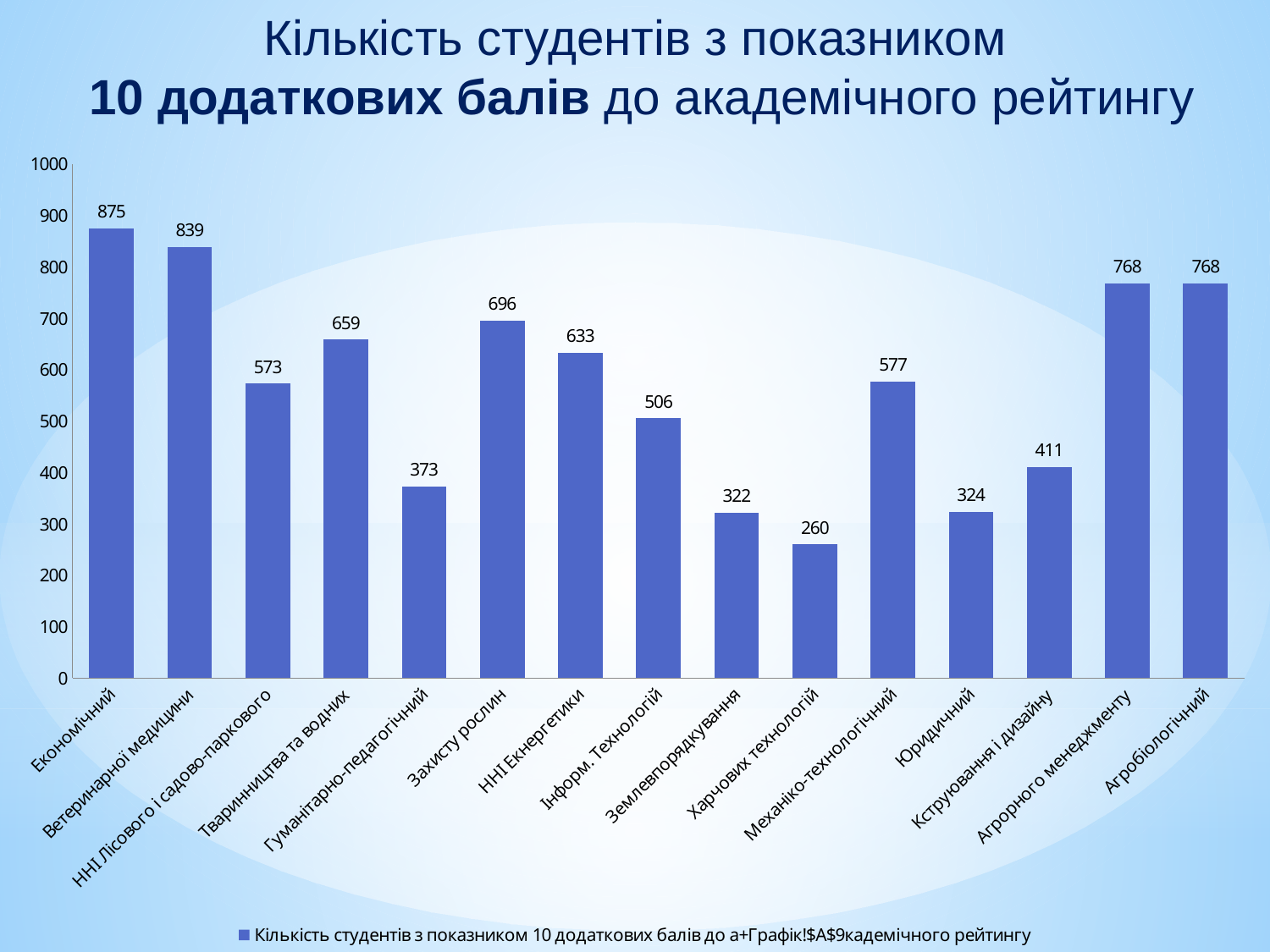
What kind of chart is shown on the slide? bar chart How many series does the legend list? 1 How many categories are shown on the x axis? 15 Which category has the highest value? Економічний What is the difference between the values for Економічний and Ветеринарної медицини? 36 What is the value for Економічний? 875 What is the value for Харчових технологій? 260 Which category has the lowest value? Харчових технологій What is the difference between the values for Юридичний and Землевпорядкування? 2 Is the value for Гуманітарно-педагогічний greater or less than 400? less What is the value for Механіко-технологічний? 577 Which is larger, the value for Захисту рослин or the value for Тваринництва та водних? Захисту рослин